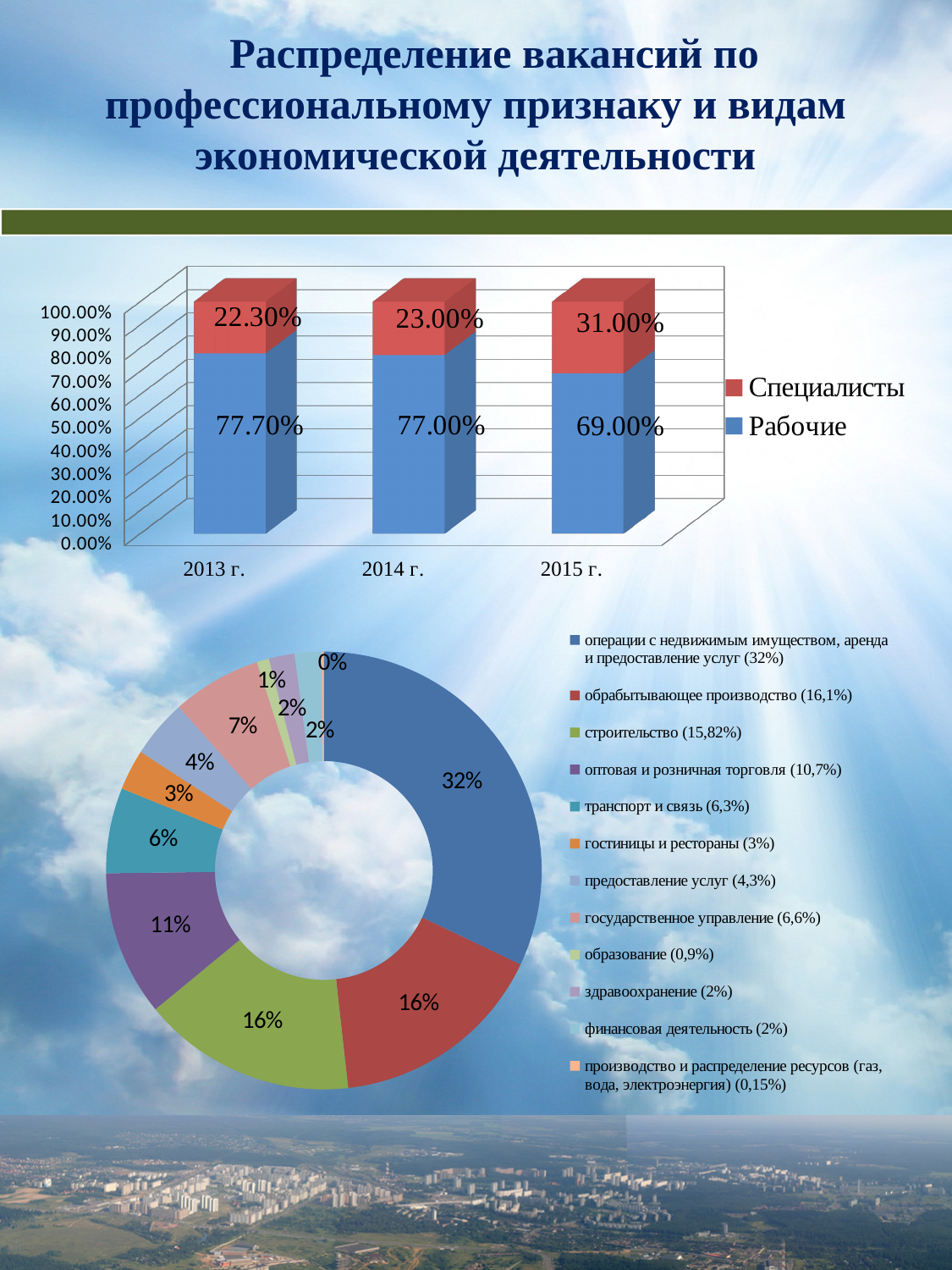
In the top bar chart, what is the difference between Рабочие and Специалисты in 2015 г.? 38.00% What kind of chart is the bottom chart on the slide? doughnut chart In the bottom doughnut chart, which is larger: оптовая и розничная торговля or транспорт и связь? оптовая и розничная торговля In the top bar chart, which year has the highest share of Специалисты? 2015 г. In the top bar chart, what is the value for Специалисты in 2013 г.? 22.30% How many series does the legend of the top bar chart list? 2 In the bottom doughnut chart, what percentage label is shown for строительство? 16% In the bottom doughnut chart, which category has the largest share? операции с недвижимым имуществом, аренда и предоставление услуг In the top bar chart, what is the value for Рабочие in 2015 г.? 69.00% What kind of chart is the top chart on the slide? bar chart How many years are shown on the x axis of the top bar chart? 3 In the top bar chart, does the share of Рабочие rise or fall from 2013 г. to 2015 г.? fall